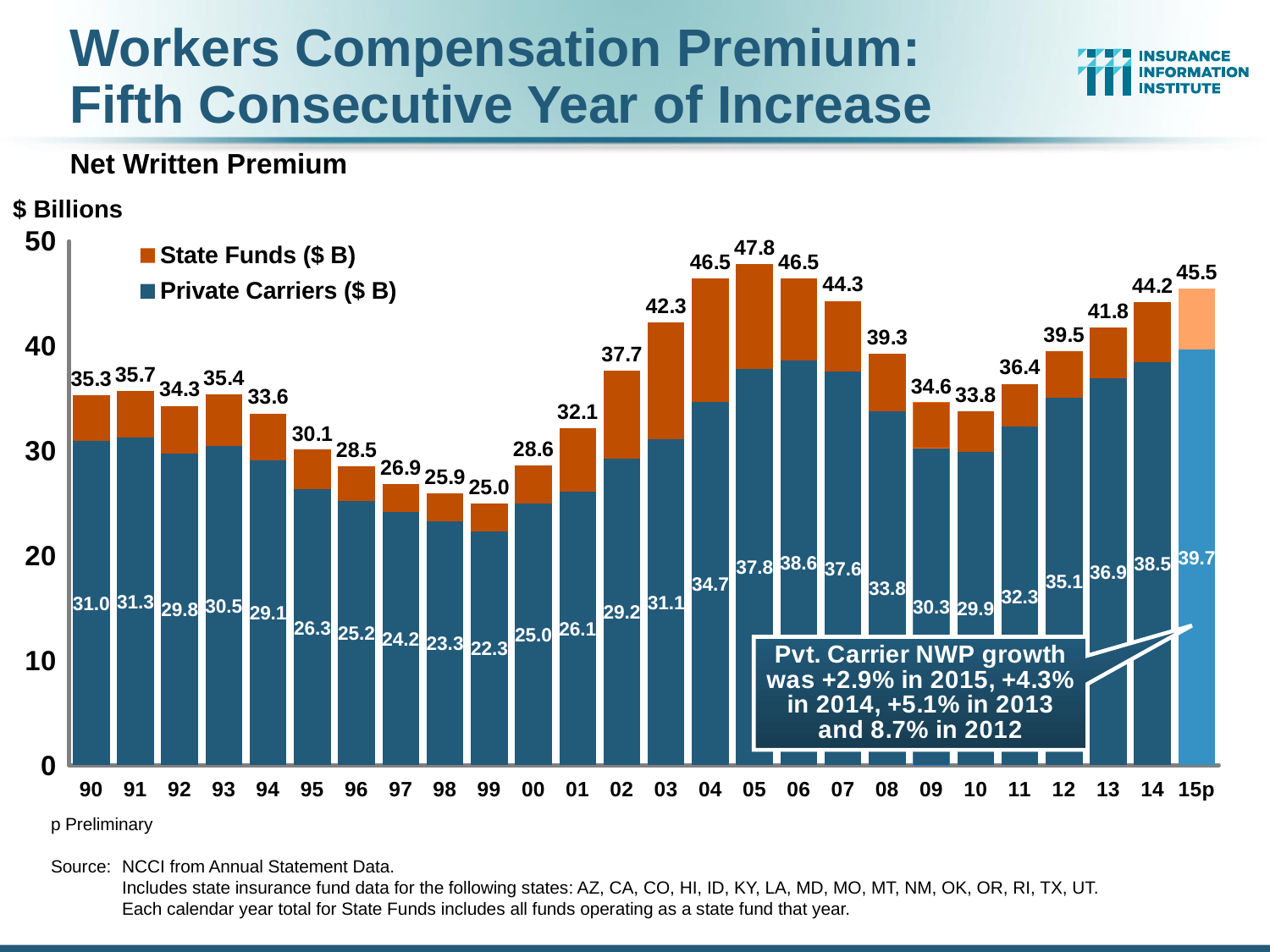
What was the Private Carriers net written premium in 2005? 37.8 Which year has the lowest total net written premium? 99 Which is larger, the total net written premium in 2004 or in 2006? They are equal (46.5) What is the difference between the total net written premium in 2014 and in 2013? 2.4 What is the unit shown on the y axis? $ Billions Which year has the highest Private Carriers value? 15p Which year has the highest total net written premium? 05 What was the total net written premium (top-of-bar label) for 2015p? 45.5 How many years are shown on the x axis? 26 What type of chart is shown on the slide? Stacked bar chart How many series does the legend list? 2 Is the total net written premium for 2003 greater or less than 40? greater